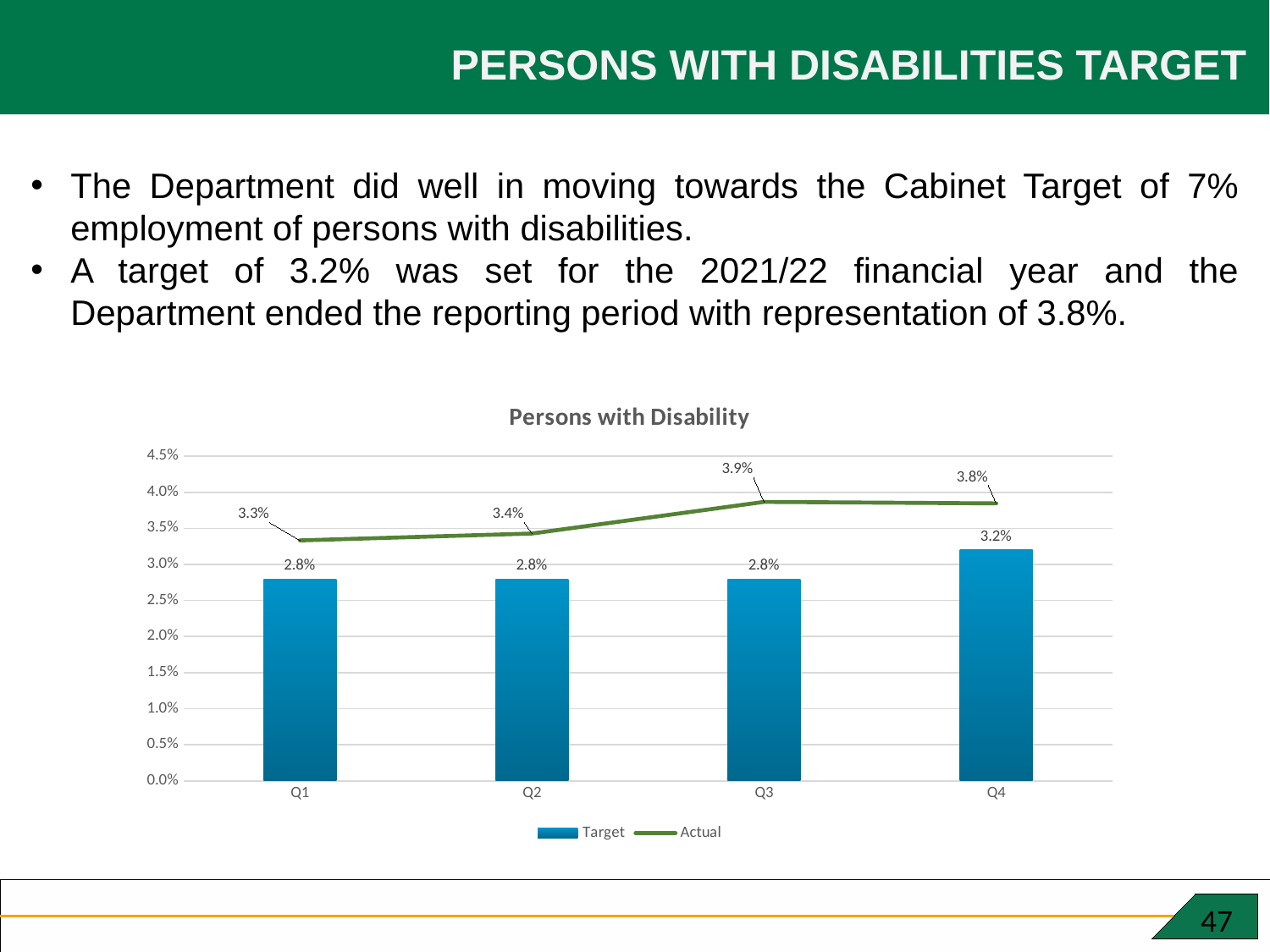
Which is larger in Q2, the Target value or the Actual value? Actual What is the Target value for Q4? 3.2% Does the Target value rise or fall from Q3 to Q4? rise How many series does the legend list? 2 In which quarter is the Actual value lowest? Q1 What is the Actual value for Q3? 3.9% How many quarters are shown on the x axis? 4 What is the title of the chart? Persons with Disability What is the Actual value for Q1? 3.3% What is the difference between the Actual and Target values in Q4? 0.6% What is the difference between the Actual values in Q3 and Q1? 0.6% In which quarter is the Actual value highest? Q3